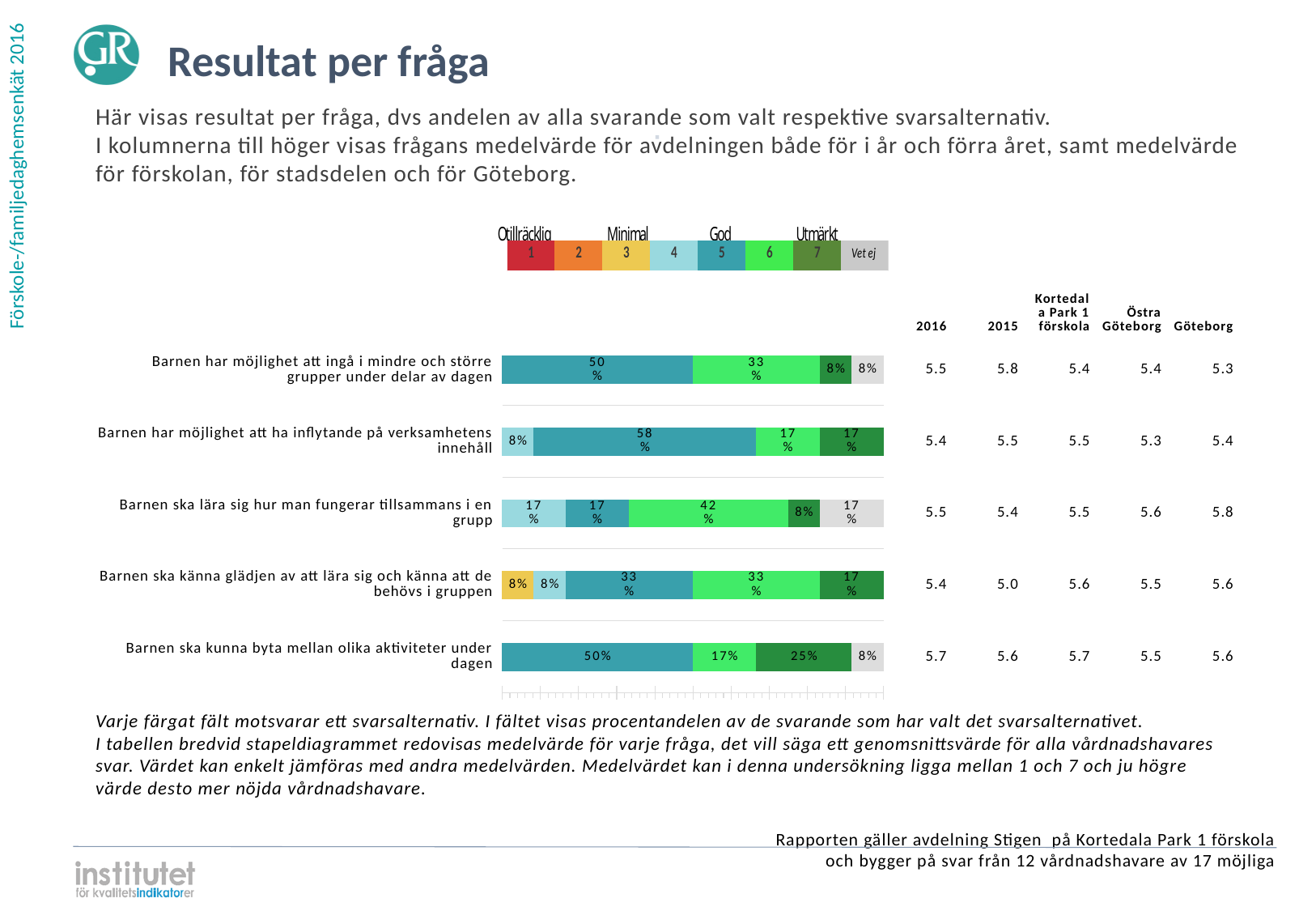
What percentage chose option 7 for "Barnen ska kunna byta mellan olika aktiviteter under dagen"? 25% What kind of chart is used to show the results per question on the slide? Stacked bar chart Which response option has the largest share for "Barnen ska lära sig hur man fungerar tillsammans i en grupp"? 6 How many response categories does the legend above the chart list? 8 What percentage chose option 6 for "Barnen ska lära sig hur man fungerar tillsammans i en grupp"? 42% What percentage chose option 5 for "Barnen har möjlighet att ha inflytande på verksamhetens innehåll"? 58% What percentage answered "Vet ej" for "Barnen ska lära sig hur man fungerar tillsammans i en grupp"? 17% How many questions (bars) are shown in the chart? 5 What percentage of respondents chose option 5 for "Barnen har möjlighet att ingå i mindre och större grupper under delar av dagen"? 50% For "Barnen ska kunna byta mellan olika aktiviteter under dagen", which is larger: the share for option 6 or the share for option 7? Option 7 What is the difference between the option 5 share and the option 6 share for "Barnen har möjlighet att ha inflytande på verksamhetens innehåll"? 41% What is the 2016 mean value shown for "Barnen ska kunna byta mellan olika aktiviteter under dagen"? 5.7